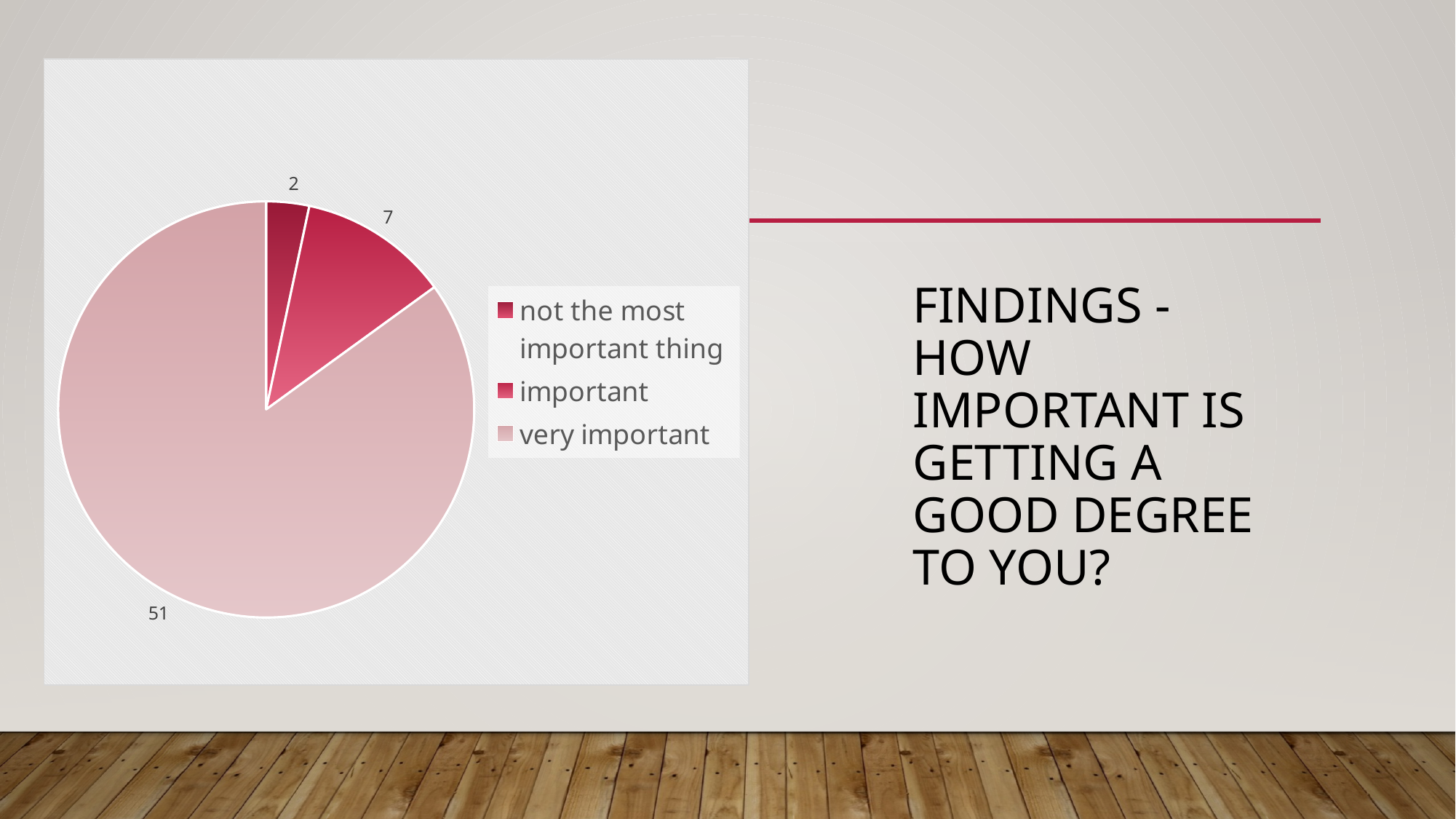
Which category has the largest slice of the pie? very important What is the value for the 'important' slice? 7 What share of the pie does the 'very important' slice represent? 85% What is the total of all the slice values in the pie chart? 60 Which category has the smallest slice of the pie? not the most important thing Which is larger, the value for 'important' or the value for 'not the most important thing'? important What is the value for the 'very important' slice? 51 What is the value for the 'not the most important thing' slice? 2 What is the difference between the 'very important' and 'important' values? 44 What type of chart is shown on the slide? pie chart How many slices does the pie chart have? 3 What is the difference between the 'important' and 'not the most important thing' values? 5